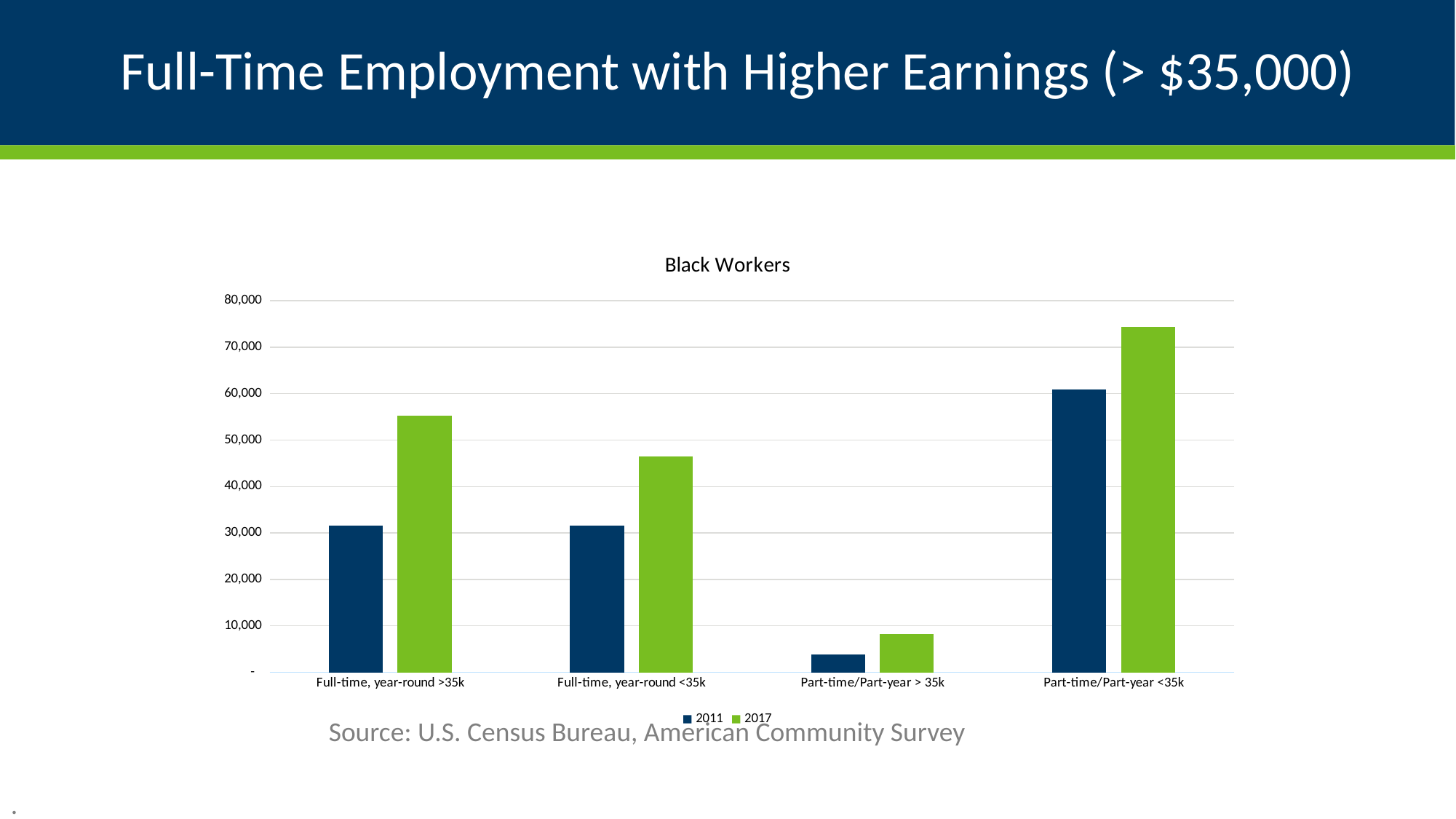
For 2017, which is larger: Full-time, year-round >35k or Full-time, year-round <35k? Full-time, year-round >35k What kind of chart is shown on the slide? Bar chart How many categories are shown on the x axis? 4 Which series is shown in green? 2017 What is the title of the chart? Black Workers Is the 2011 value for Full-time, year-round >35k greater or less than 40,000? less How many series does the legend list? 2 Which category has the highest value for 2017? Part-time/Part-year <35k Is the 2017 value for Part-time/Part-year <35k greater or less than 70,000? greater Which category has the lowest value for 2011? Part-time/Part-year > 35k For Full-time, year-round >35k, which year has the larger value, 2011 or 2017? 2017 Is the 2017 value for Part-time/Part-year > 35k greater or less than 10,000? less